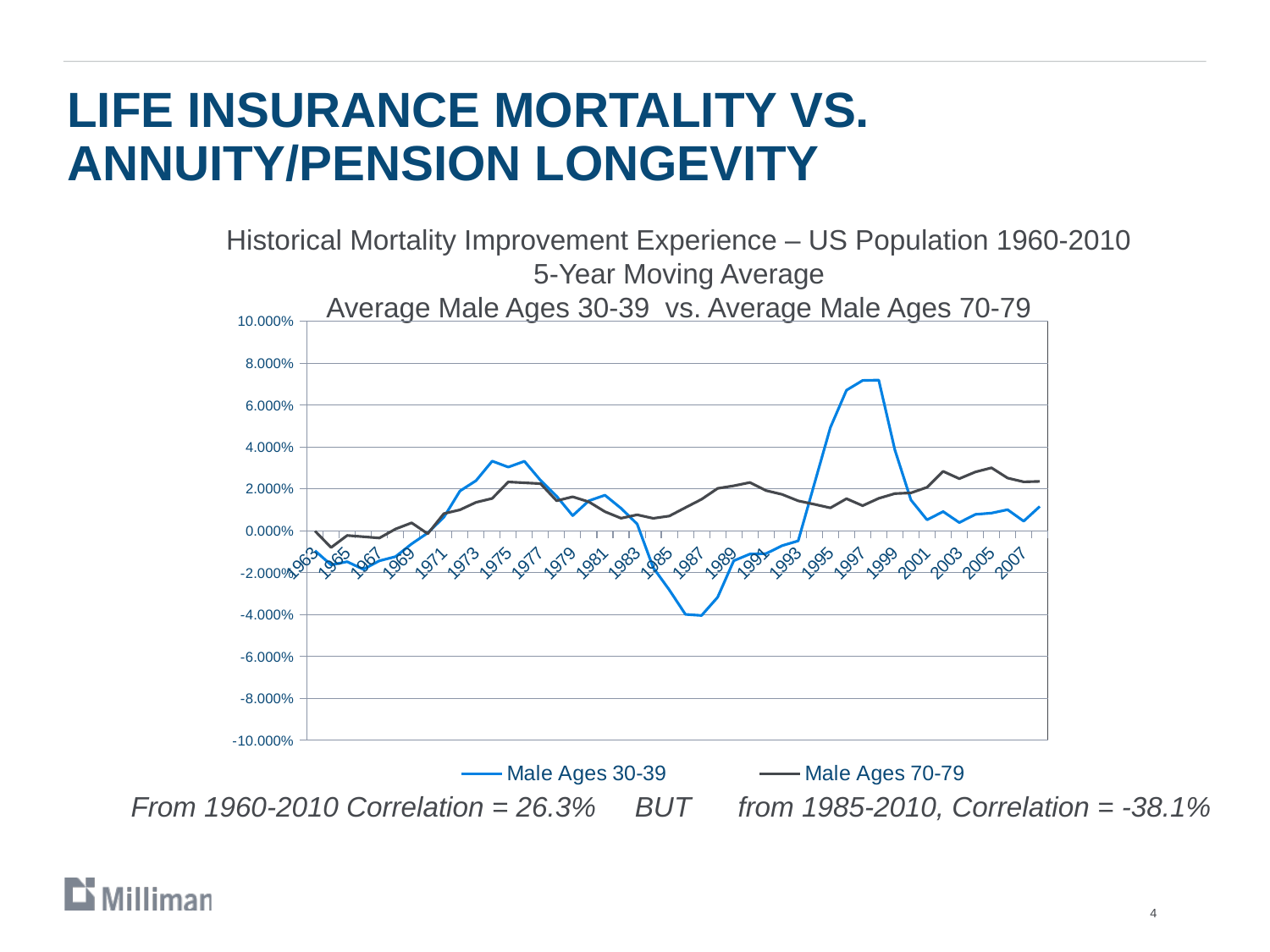
Is the value for Male Ages 30-39 in 1965 greater or less than 0.000%? less In 1997, which series has the higher value, Male Ages 30-39 or Male Ages 70-79? Male Ages 30-39 Is the value for Male Ages 30-39 in 1987 greater or less than -2.000%? less What is the highest value shown on the vertical axis? 10.000% Is the value for Male Ages 70-79 in 1997 greater or less than 4.000%? less How many series does the legend list? 2 What are the two series named in the legend? Male Ages 30-39 and Male Ages 70-79 Does the Male Ages 30-39 line rise or fall between 1993 and 1997? rise In 1987, which series has the higher value, Male Ages 30-39 or Male Ages 70-79? Male Ages 70-79 What kind of chart is shown on the slide? line chart